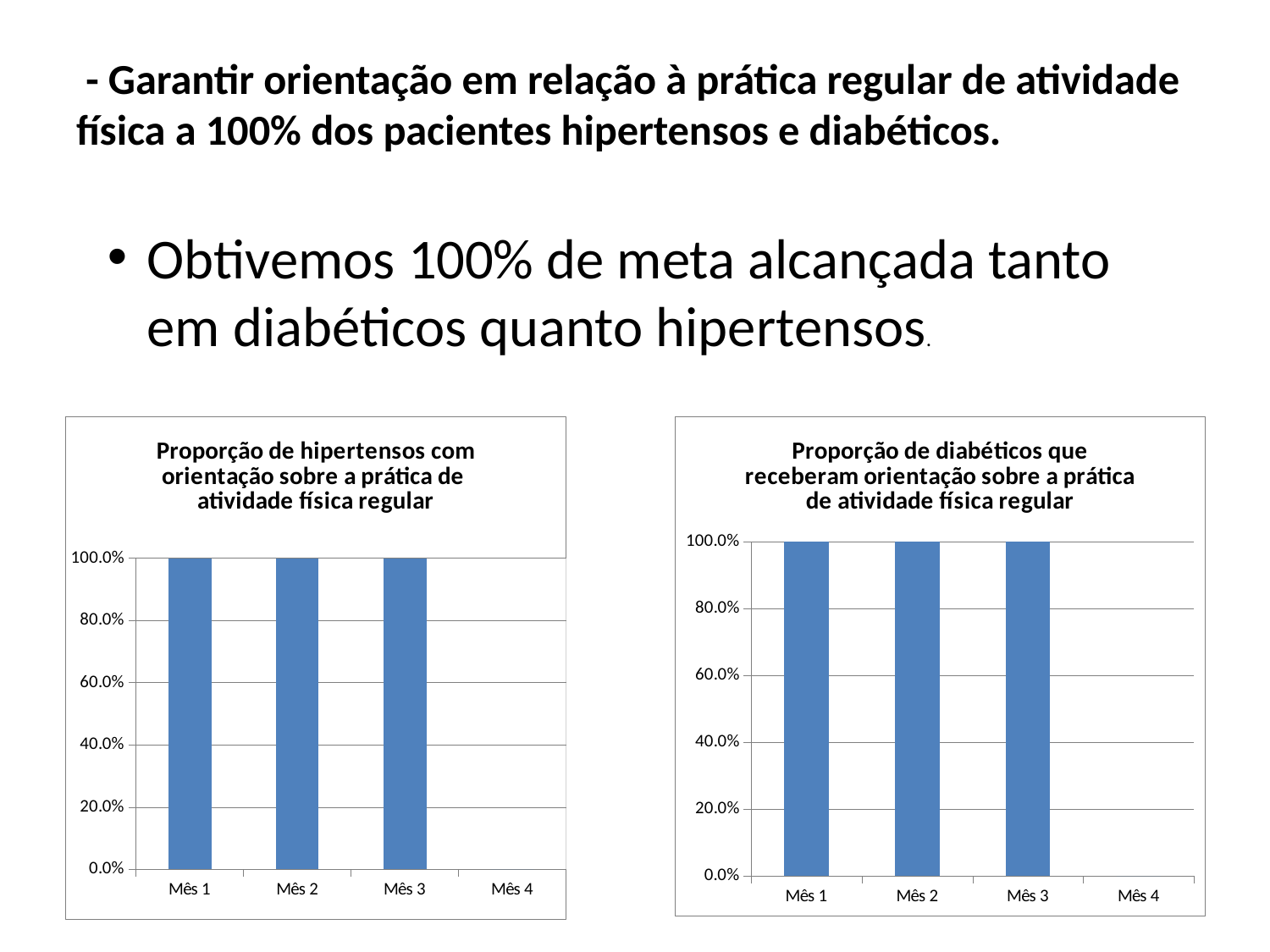
In the left chart (Proporção de hipertensos com orientação sobre a prática de atividade física regular), what is the value for Mês 3? 100.0% What kind of chart is the right chart (Proporção de diabéticos que receberam orientação sobre a prática de atividade física regular)? bar chart In the right chart (Proporção de diabéticos que receberam orientação sobre a prática de atividade física regular), is the value for Mês 1 greater or less than 60.0%? greater In the left chart (Proporção de hipertensos com orientação sobre a prática de atividade física regular), how many categories are shown on the x axis? 4 In the left chart (Proporção de hipertensos com orientação sobre a prática de atividade física regular), what is the value for Mês 1? 100.0% In the left chart (Proporção de hipertensos com orientação sobre a prática de atividade física regular), what is the difference between the values for Mês 1 and Mês 3? 0.0% In the right chart (Proporção de diabéticos que receberam orientação sobre a prática de atividade física regular), what is the value for Mês 3? 100.0% In the left chart (Proporção de hipertensos com orientação sobre a prática de atividade física regular), do the values rise, fall or stay the same from Mês 1 to Mês 3? stay the same In the left chart (Proporção de hipertensos com orientação sobre a prática de atividade física regular), is the value for Mês 2 greater or less than 80.0%? greater In the right chart (Proporção de diabéticos que receberam orientação sobre a prática de atividade física regular), what is the value for Mês 2? 100.0% What is the title of the left chart? Proporção de hipertensos com orientação sobre a prática de atividade física regular In the right chart (Proporção de diabéticos que receberam orientação sobre a prática de atividade física regular), how many categories are shown on the x axis? 4